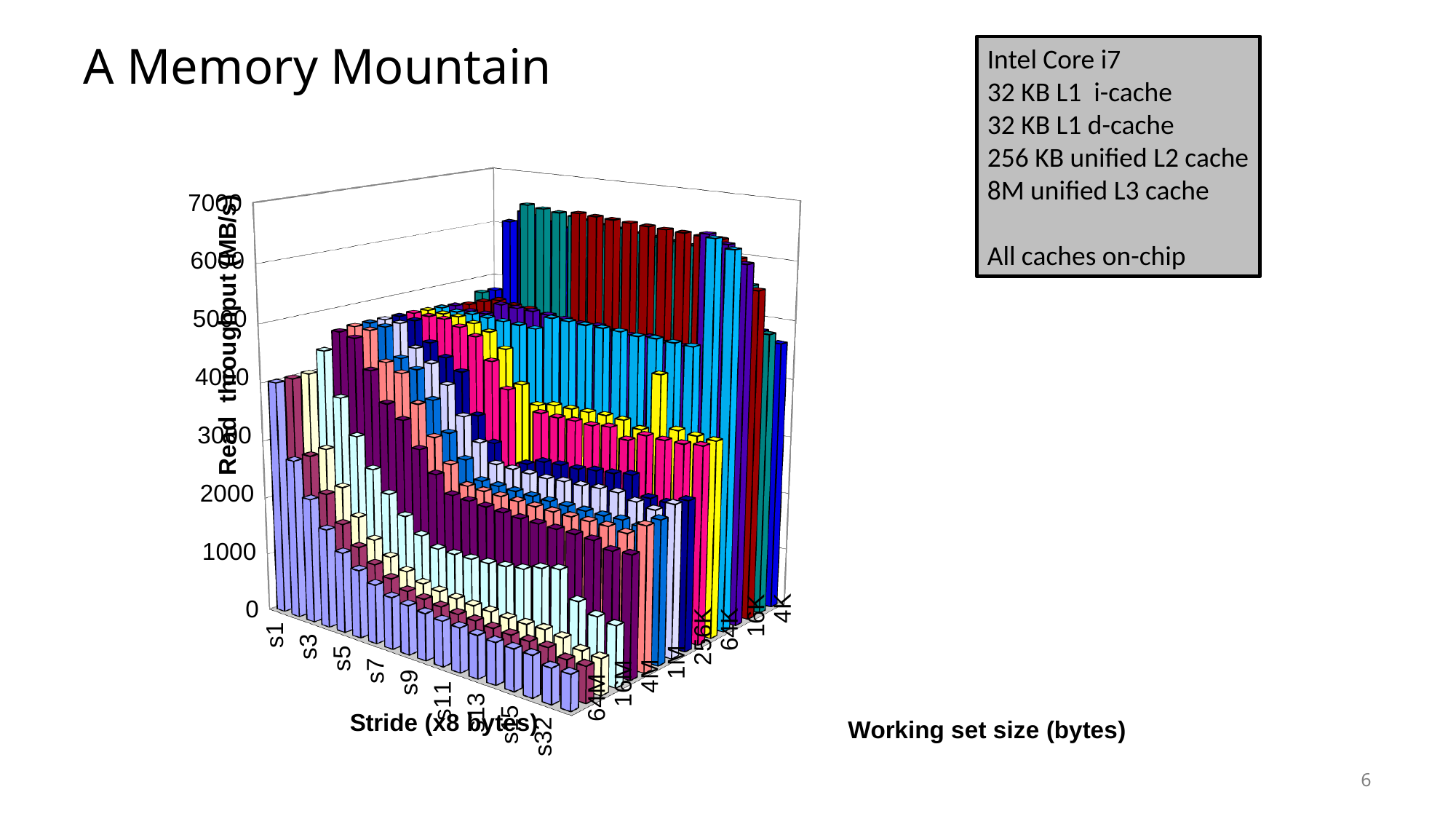
What is the smallest working set size labelled on the chart? 4K What is the highest tick value shown on the read throughput axis? 7000 What kind of chart is shown on the slide? 3D bar chart For the 64M working set, does read throughput rise or fall as the stride increases from s1 to s32? fall How many working set size labels are shown along the depth axis of the chart? 8 What is the label of the stride axis of the chart? Stride (x8 bytes) Is the read throughput for stride s1 at the 64M working set greater or less than 1000? greater What is the largest working set size labelled on the chart? 64M What is the label of the vertical axis of the chart? Read throughput (MB/s) Is the read throughput for stride s32 at the 64M working set greater or less than 1000? less Which is larger for the 64M working set: the read throughput at stride s1 or at stride s32? s1